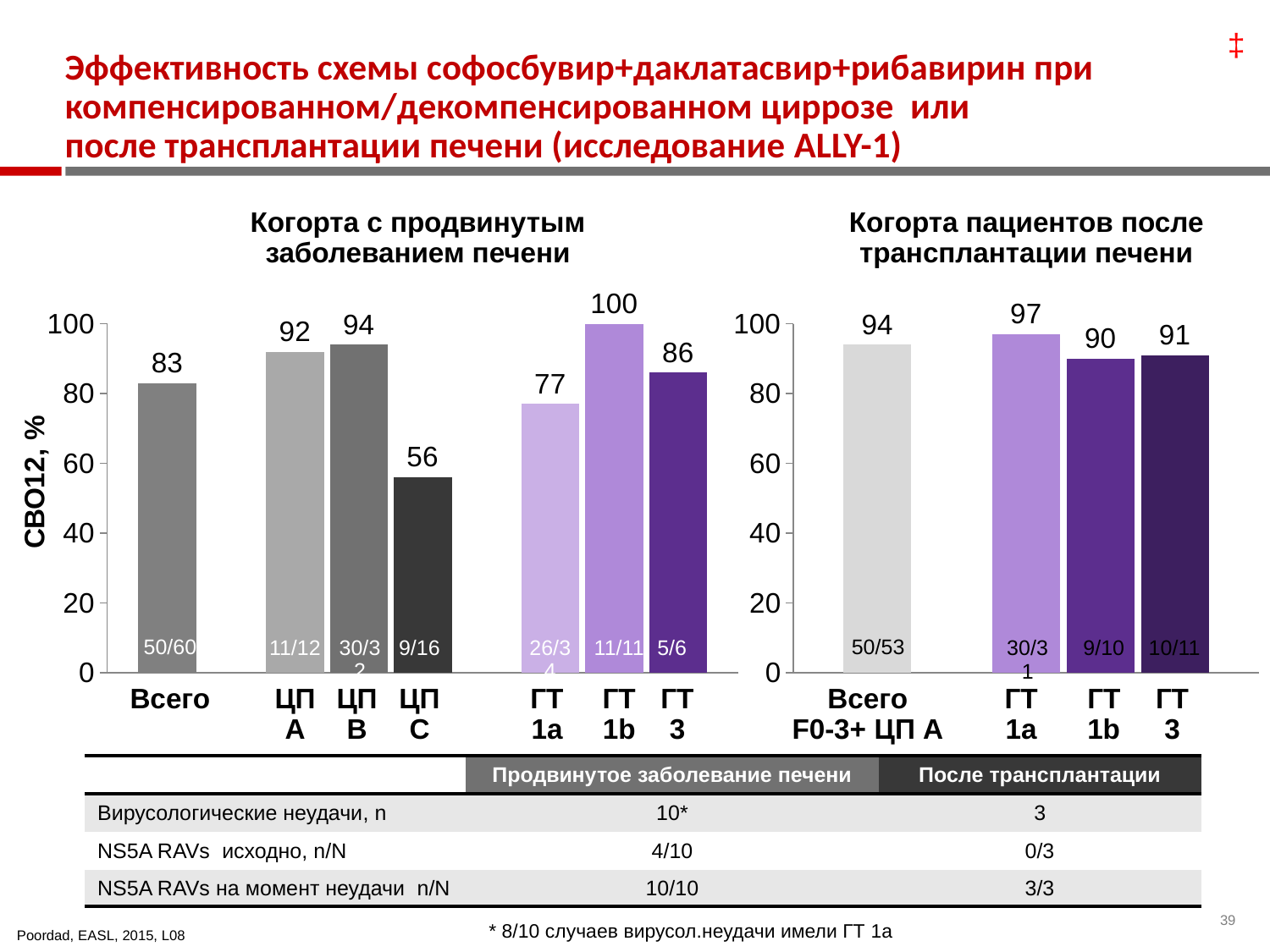
In the chart 'Когорта с продвинутым заболеванием печени', what is the СВО12 value for ЦП C? 56 In the chart 'Когорта с продвинутым заболеванием печени', what is the difference between the СВО12 values for ЦП B and ЦП C? 38 What type of chart is used on this slide? Bar chart How many bars are plotted in the chart 'Когорта с продвинутым заболеванием печени'? 7 In the chart 'Когорта пациентов после трансплантации печени', which category has the lowest СВО12 value? ГТ 1b In the chart 'Когорта с продвинутым заболеванием печени', which is larger, the СВО12 value for ГТ 1a or for ГТ 3? ГТ 3 In the chart 'Когорта пациентов после трансплантации печени', what is the difference between the СВО12 values for ГТ 1a and ГТ 1b? 7 In the chart 'Когорта с продвинутым заболеванием печени', what is the СВО12 value for Всего? 83 How many bars are plotted in the chart 'Когорта пациентов после трансплантации печени'? 4 In the chart 'Когорта с продвинутым заболеванием печени', which category has the highest СВО12 value? ГТ 1b In the chart 'Когорта пациентов после трансплантации печени', what is the СВО12 value for ГТ 1a? 97 In the chart 'Когорта с продвинутым заболеванием печени', which category has the lowest СВО12 value? ЦП C